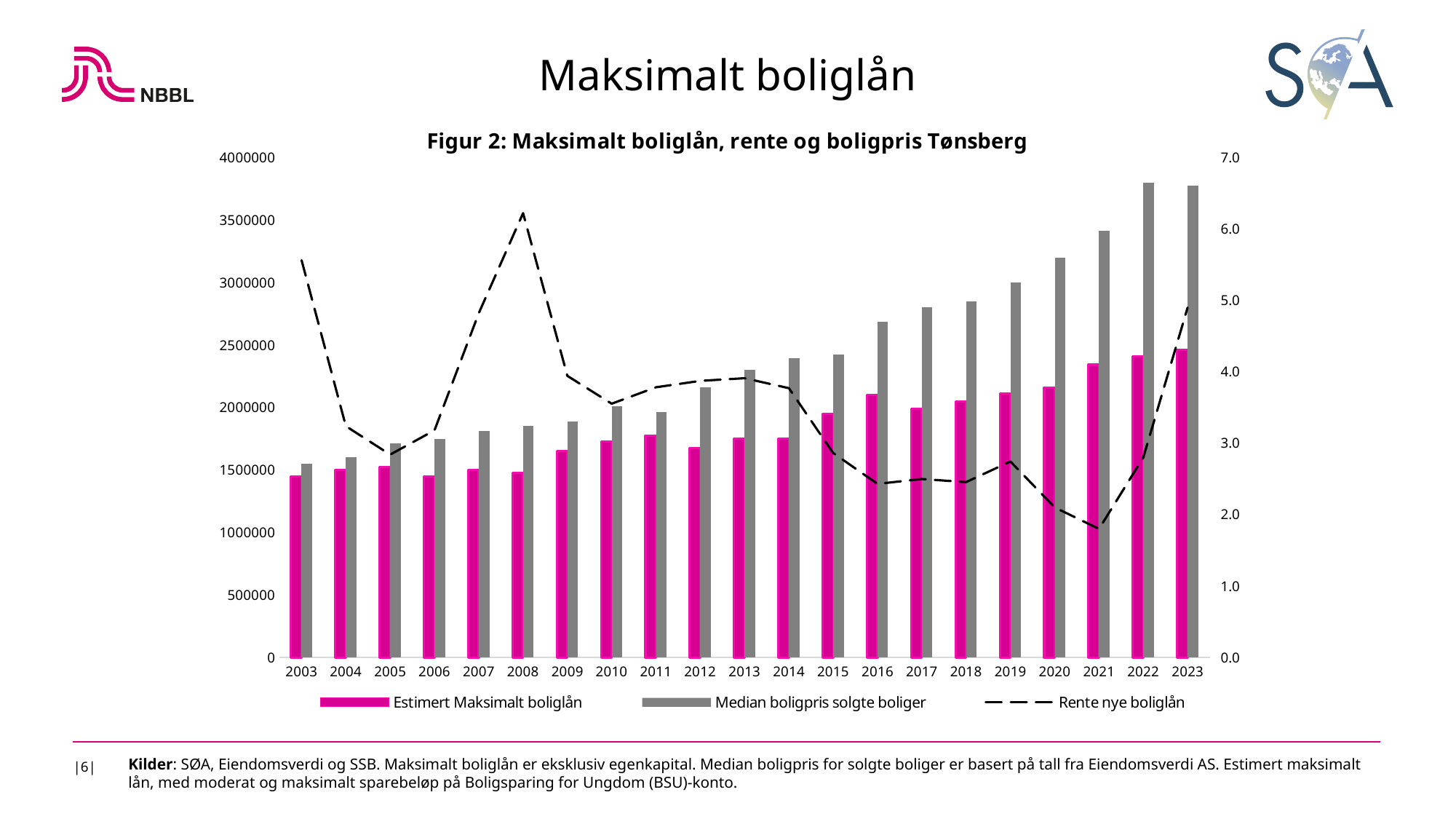
How many series does the legend list? 3 In 2023, which is larger: Estimert Maksimalt boliglån or Median boligpris solgte boliger? Median boligpris solgte boliger In which year is the Rente nye boliglån line at its lowest? 2021 In which year is the Rente nye boliglån line at its highest? 2008 Is the Median boligpris solgte boliger value for 2003 greater or less than 2000000? less How many years are shown on the x axis? 21 In which year is Median boligpris solgte boliger lowest? 2003 Is the Rente nye boliglån value for 2021 greater or less than 2.0? less What kind of chart is this? Bar chart with a dashed line series Is the Median boligpris solgte boliger value for 2023 greater or less than 3500000? greater What is the title of the chart? Figur 2: Maksimalt boliglån, rente og boligpris Tønsberg Does Median boligpris solgte boliger generally rise or fall from 2003 to 2023? rise